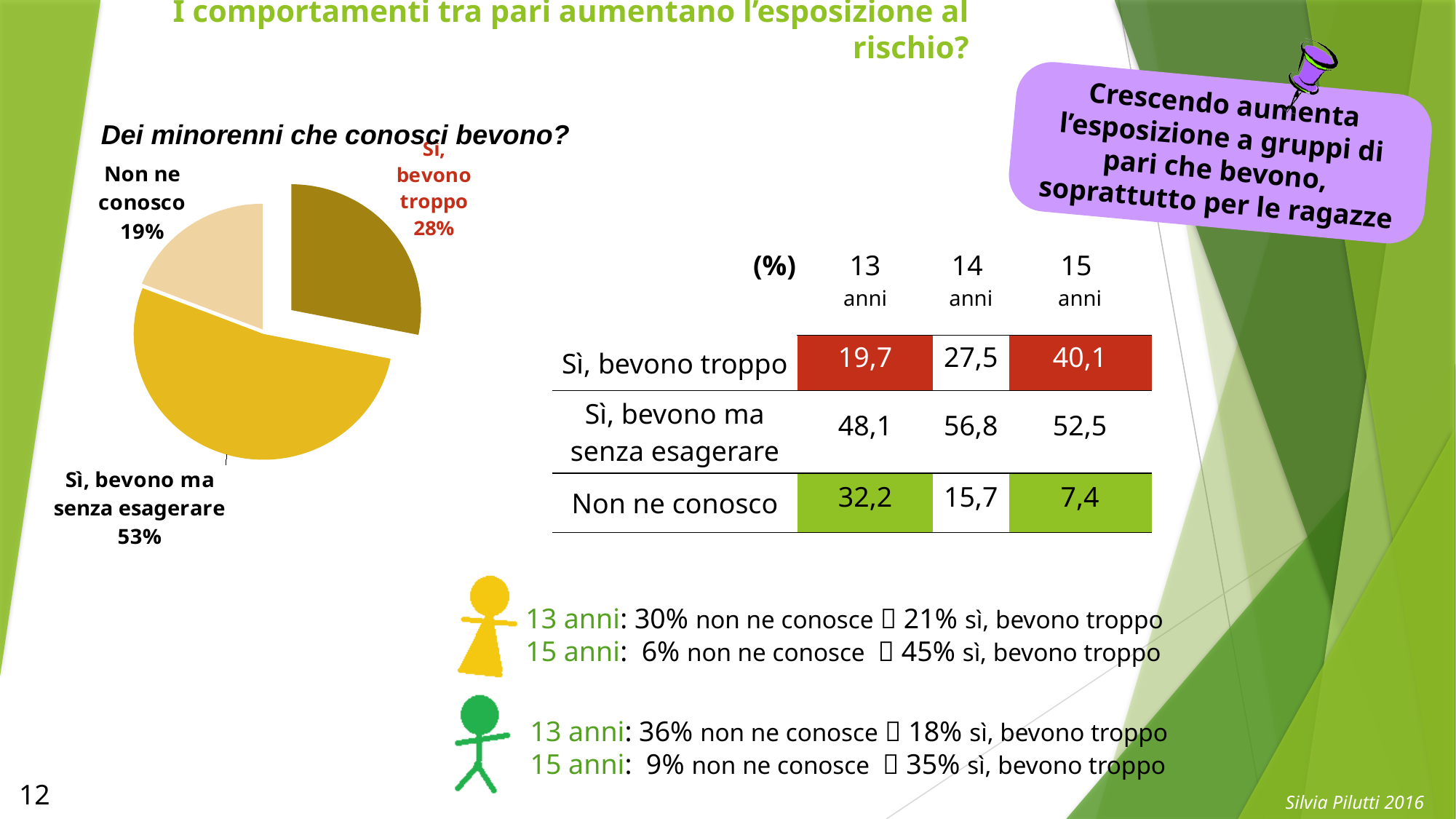
In the pie chart, what percentage is shown for "Non ne conosco"? 19% In the pie chart, which is larger: "Sì, bevono troppo" or "Non ne conosco"? Sì, bevono troppo Which slice of the pie chart is the largest? Sì, bevono ma senza esagerare What is the title of the pie chart? Dei minorenni che conosci bevono? In the pie chart, what percentage is shown for "Sì, bevono troppo"? 28% Which slice of the pie chart is pulled out (exploded) from the rest of the pie? Sì, bevono troppo How many slices does the pie chart have? 3 In the pie chart, what is the difference between the "Sì, bevono ma senza esagerare" share and the "Sì, bevono troppo" share? 25% In the pie chart, what is the difference between the "Sì, bevono troppo" share and the "Non ne conosco" share? 9% In the pie chart, what percentage is shown for "Sì, bevono ma senza esagerare"? 53% What kind of chart is shown under the heading "Dei minorenni che conosci bevono?"? pie chart Which slice of the pie chart is the smallest? Non ne conosco